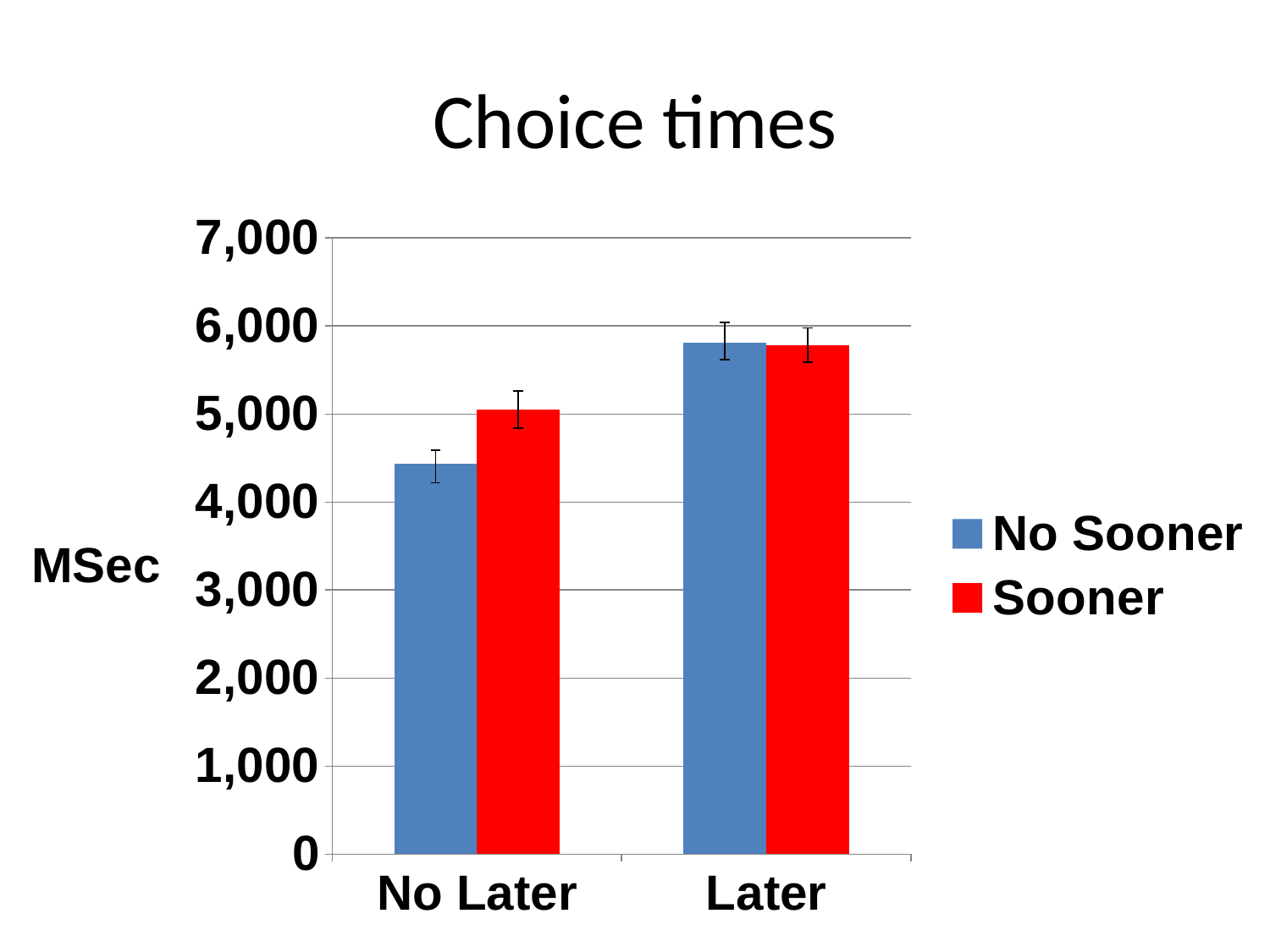
In the No Later category, which series has the larger value, No Sooner or Sooner? Sooner Is the value for No Sooner in the No Later category greater or less than 5,000? less What is the title of the chart? Choice times Is the value for Sooner in the Later category greater or less than 5,000? greater For the No Sooner series, which category has the lower value? No Later For the Sooner series, which category has the higher value? Later How many series does the legend list? 2 How many categories are shown on the x axis? 2 What is the label of the y axis? MSec What kind of chart is shown on the slide? bar chart Is the value for No Sooner in the Later category greater or less than 6,000? less